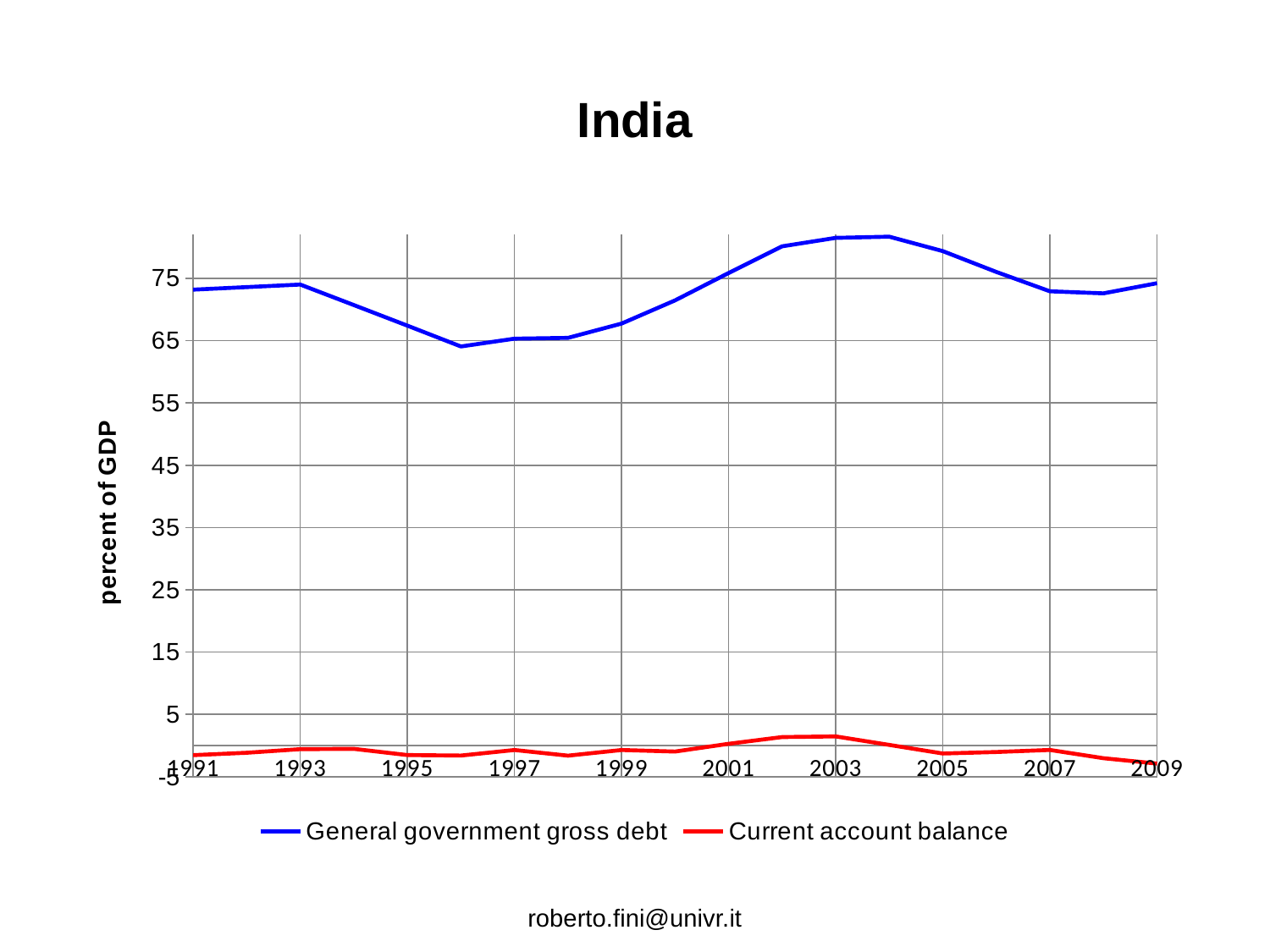
Does General government gross debt rise or fall between 1999 and 2003? rise What kind of chart is shown on the slide? line chart In which year is Current account balance at its lowest? 2009 What is the label on the vertical axis? percent of GDP How many years are labelled on the x axis? 10 Is the value of General government gross debt in 1996 greater or less than 70? less Which is larger for General government gross debt: the value in 1999 or the value in 2003? 2003 How many series does the legend list? 2 In which year is General government gross debt at its lowest? 1996 Is the value of General government gross debt in 2003 greater or less than 75? greater What is the title of the chart? India Is the value of General government gross debt in 1991 greater or less than 65? greater